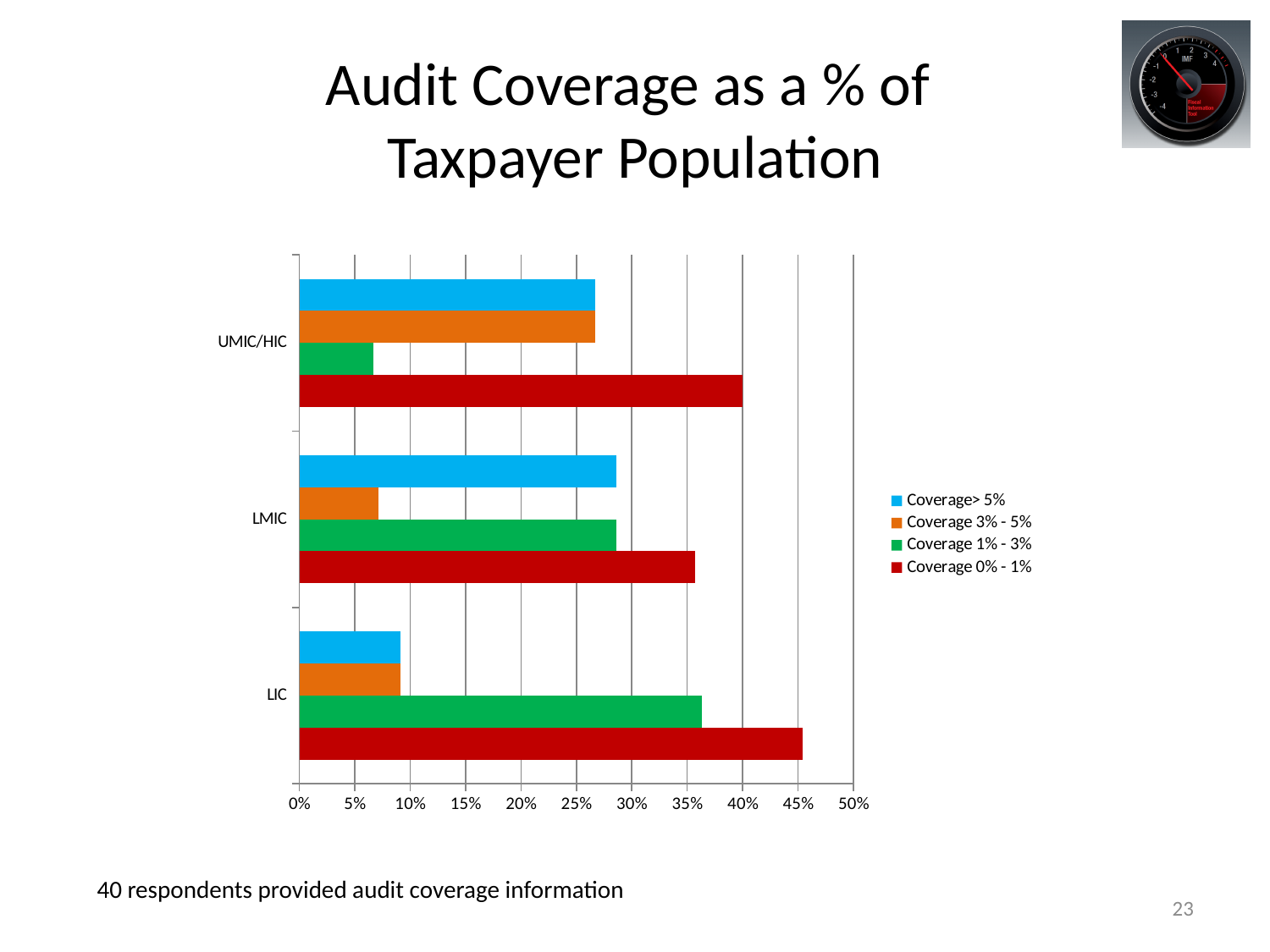
Which series has the shortest bar for the UMIC/HIC category? Coverage 1% - 3% For the LIC category, which is larger: Coverage 1% - 3% or Coverage> 5%? Coverage 1% - 3% Which series has the longest bar for the LIC category? Coverage 0% - 1% How many series does the chart's legend list? 4 Is the value for Coverage 3% - 5% in the LMIC category greater or less than 10%? less Which series has the longest bar for the UMIC/HIC category? Coverage 0% - 1% How many categories are shown on the vertical axis of the chart? 3 Is the value for Coverage 0% - 1% in the LMIC category greater or less than 30%? greater Is the value for Coverage 0% - 1% in the LIC category greater or less than 40%? greater What is the title of the chart on the slide? Audit Coverage as a % of Taxpayer Population What kind of chart is shown on the slide? bar chart